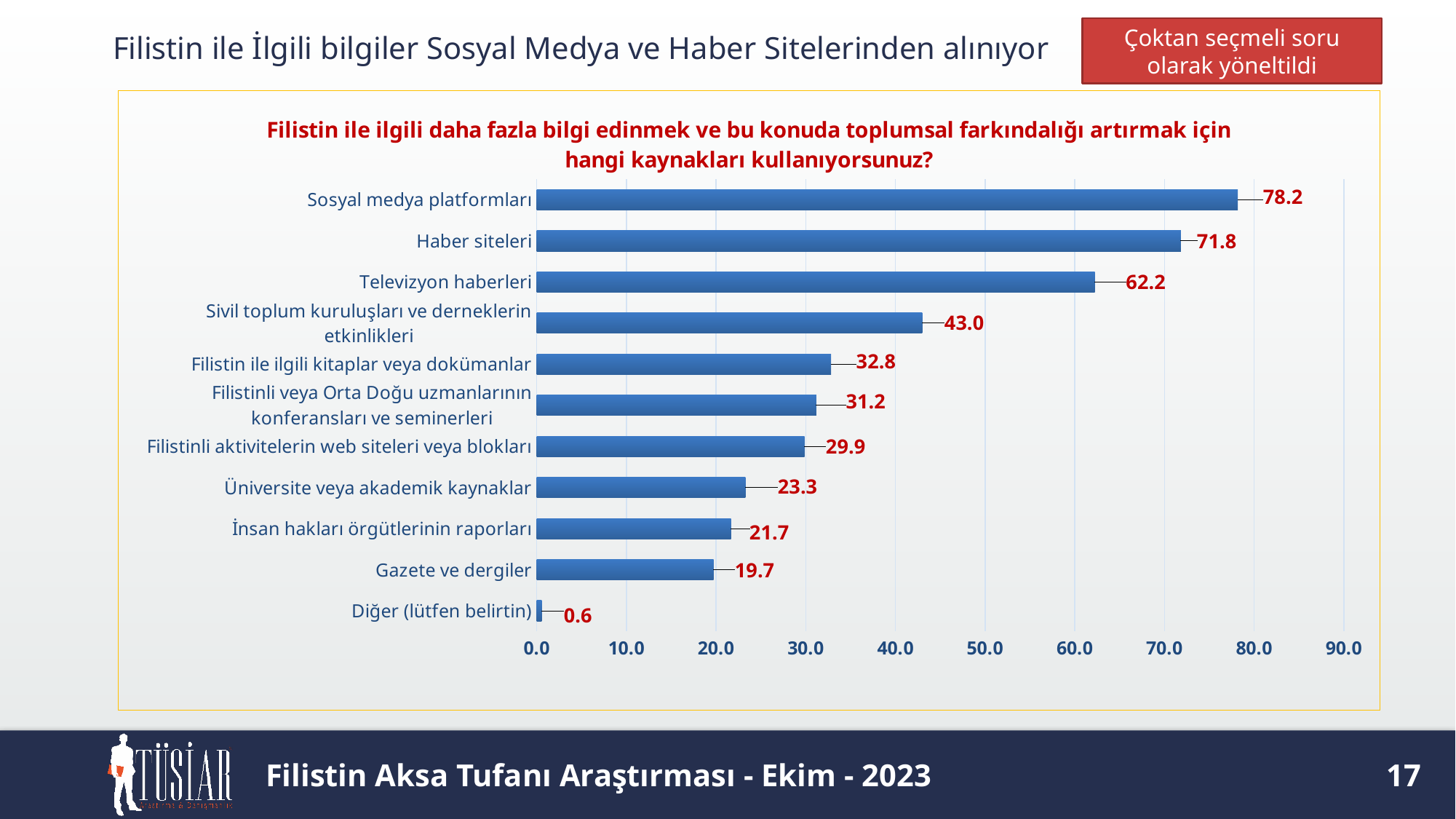
What is the difference between the values for Sosyal medya platformları and Haber siteleri? 6.4 How many categories are shown in the chart? 11 What is the value for Filistinli aktivitelerin web siteleri veya blokları? 29.9 What is the value for Gazete ve dergiler? 19.7 Which category has the lowest value? Diğer (lütfen belirtin) Which category has the highest value? Sosyal medya platformları Which is larger: the value for Üniversite veya akademik kaynaklar or the value for İnsan hakları örgütlerinin raporları? Üniversite veya akademik kaynaklar What is the value for Sosyal medya platformları? 78.2 What is the highest tick value shown on the horizontal axis? 90.0 Is the value for Sivil toplum kuruluşları ve derneklerin etkinlikleri greater or less than 40.0? greater What is the value for Televizyon haberleri? 62.2 What kind of chart is shown on the slide? bar chart